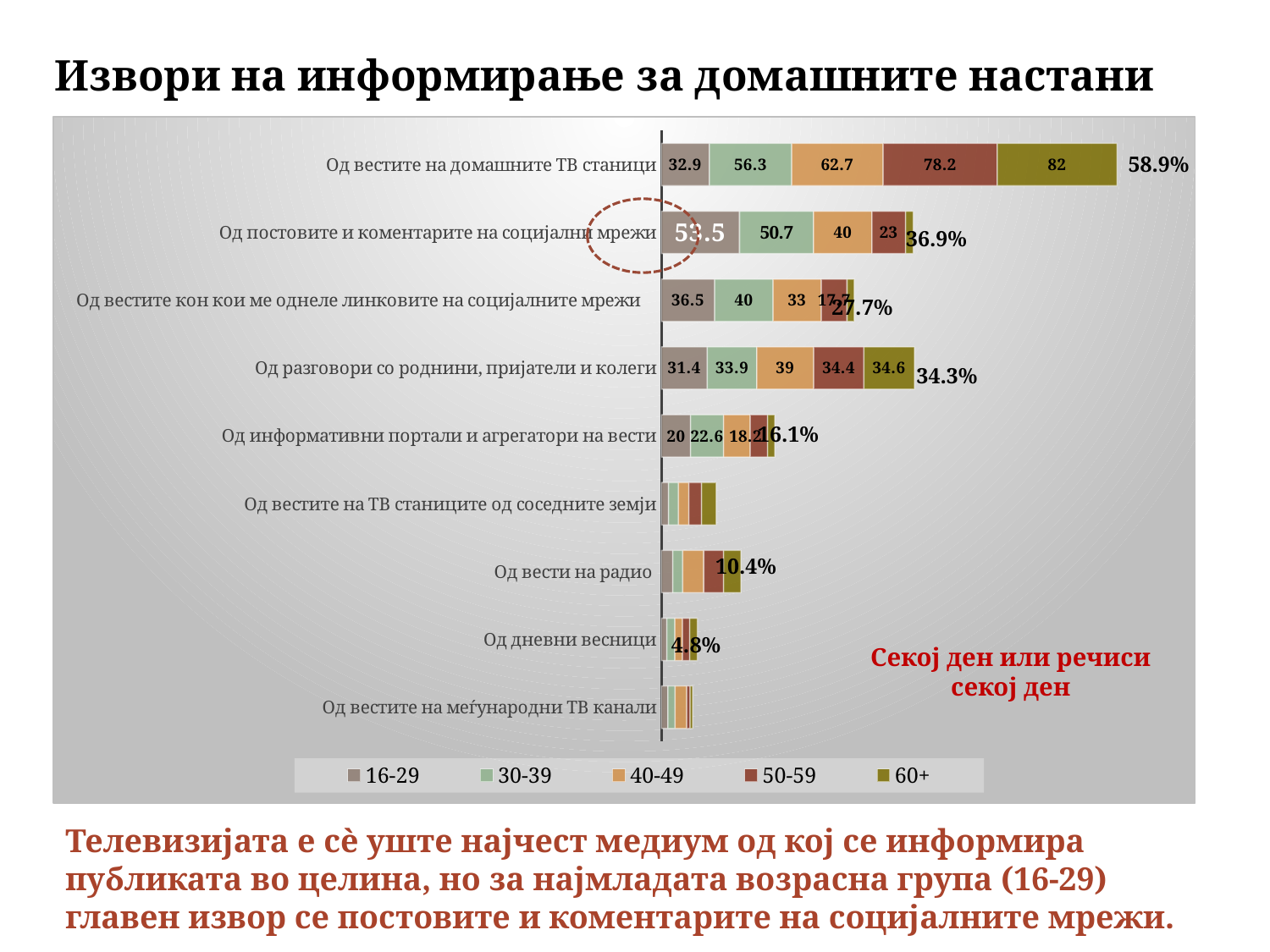
What is the value for the 16-29 age group for 'Од информативни портали и агрегатори на вести'? 20 For the 30-39 age group, which is larger: the value for 'Од постовите и коментарите на социјални мрежи' or for 'Од вестите кон кои ме однеле линковите на социјалните мрежи'? Од постовите и коментарите на социјални мрежи What is the difference between the 60+ and 16-29 values for 'Од вестите на домашните ТВ станици'? 49.1 How many series does the legend list? 5 What is the value for the 60+ age group for 'Од вестите на домашните ТВ станици'? 82 Which age group has the lowest value for 'Од разговори со роднини, пријатели и колеги'? 16-29 What is the value for the 30-39 age group for 'Од вестите на домашните ТВ станици'? 56.3 Which age group has the highest value for 'Од вестите на домашните ТВ станици'? 60+ What kind of chart is shown on the slide? Stacked bar chart What is the value for the 40-49 age group for 'Од разговори со роднини, пријатели и колеги'? 39 How many categories (information sources) are plotted on the chart? 9 What is the value for the 50-59 age group for 'Од вестите на домашните ТВ станици'? 78.2